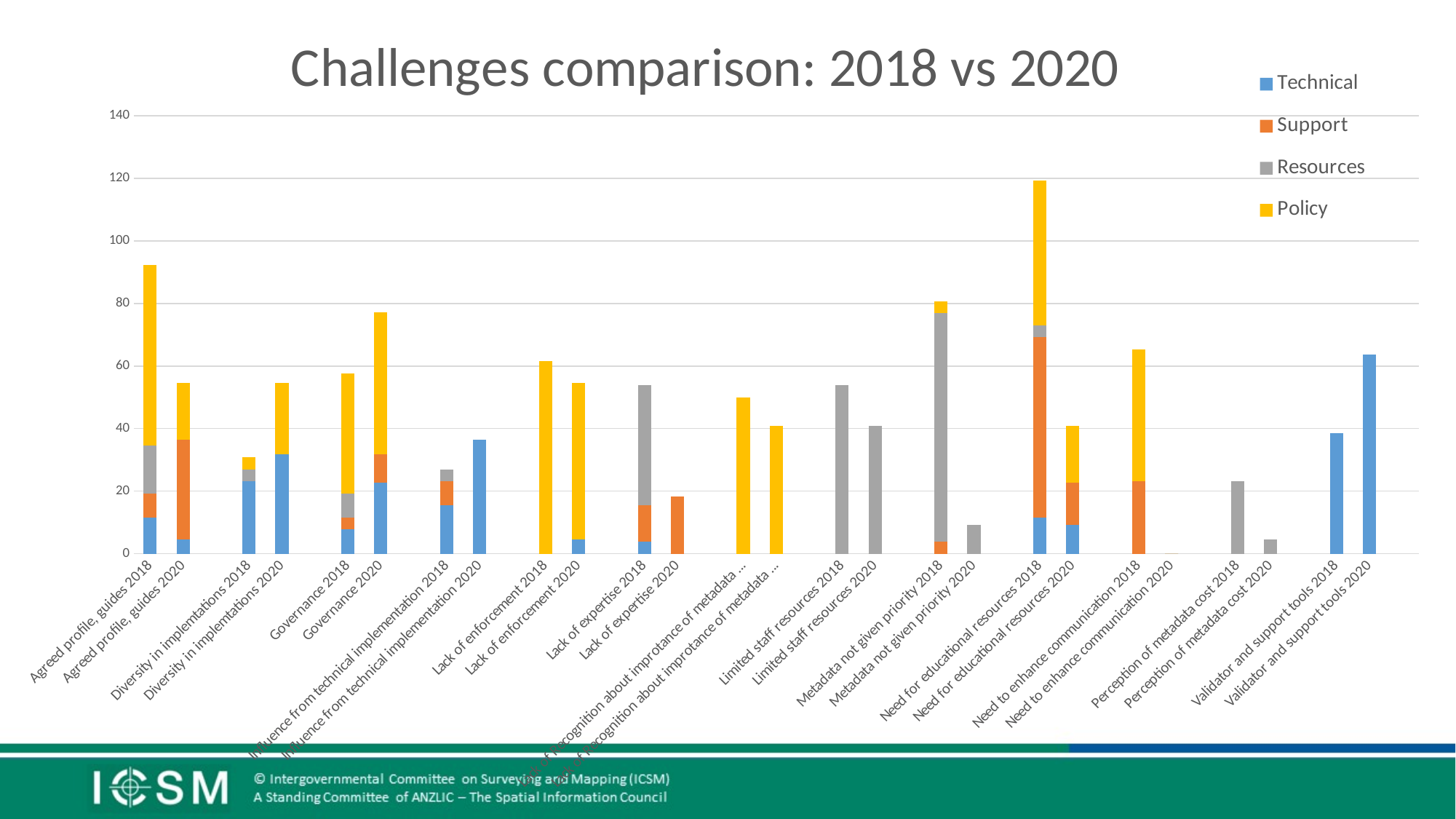
Which colour represents the Policy series in the legend? Yellow What kind of chart is shown on the slide? Stacked bar chart Is the value for Validator and support tools 2020 greater or less than 60? greater Which category has the highest total bar? Need for educational resources 2018 Is the total value for Governance 2020 greater or less than 80? less Which is larger, the value for Validator and support tools 2018 or Validator and support tools 2020? Validator and support tools 2020 What is the title of the chart? Challenges comparison: 2018 vs 2020 Which is larger, the total for Agreed profile, guides 2018 or Agreed profile, guides 2020? Agreed profile, guides 2018 Is the total value for Agreed profile, guides 2018 greater or less than 80? greater How many series does the legend list? 4